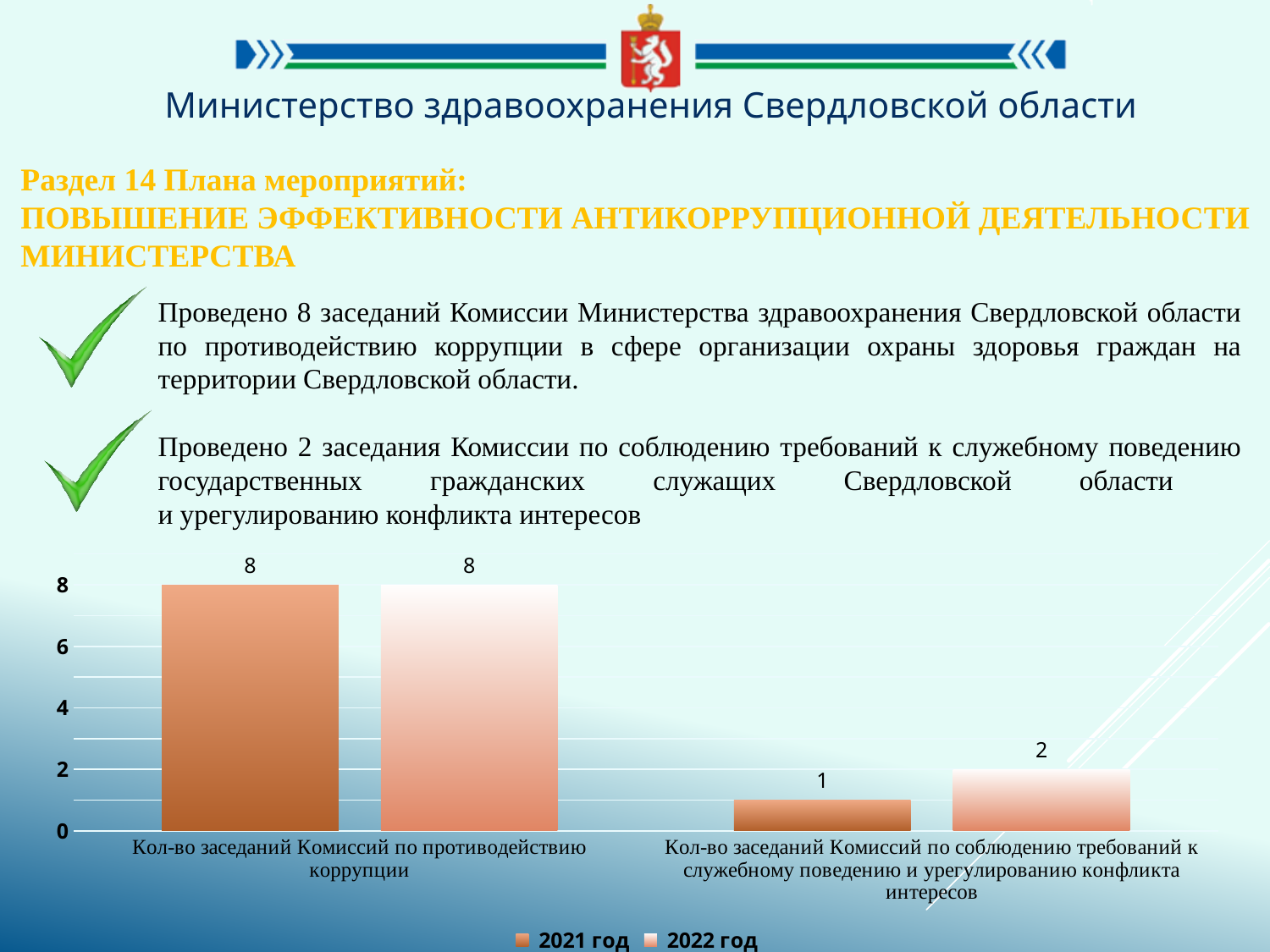
How many series does the legend list? 2 Which category has the highest value for 2022 год? Кол-во заседаний Комиссий по противодействию коррупции What are the two series named in the legend? 2021 год and 2022 год What kind of chart is shown on the slide? Bar chart How many categories are shown on the x axis of the chart? 2 Which category has the lowest value for 2021 год? Кол-во заседаний Комиссий по соблюдению требований к служебному поведению и урегулированию конфликта интересов What is the value for 2021 год for 'Кол-во заседаний Комиссий по противодействию коррупции'? 8 What is the value for 2022 год for 'Кол-во заседаний Комиссий по противодействию коррупции'? 8 For 'Кол-во заседаний Комиссий по соблюдению требований к служебному поведению и урегулированию конфликта интересов', which year has the larger value, 2021 год or 2022 год? 2022 год What is the value for 2022 год for 'Кол-во заседаний Комиссий по соблюдению требований к служебному поведению и урегулированию конфликта интересов'? 2 What is the difference between the 2022 год and 2021 год values for 'Кол-во заседаний Комиссий по соблюдению требований к служебному поведению и урегулированию конфликта интересов'? 1 What is the value for 2021 год for 'Кол-во заседаний Комиссий по соблюдению требований к служебному поведению и урегулированию конфликта интересов'? 1